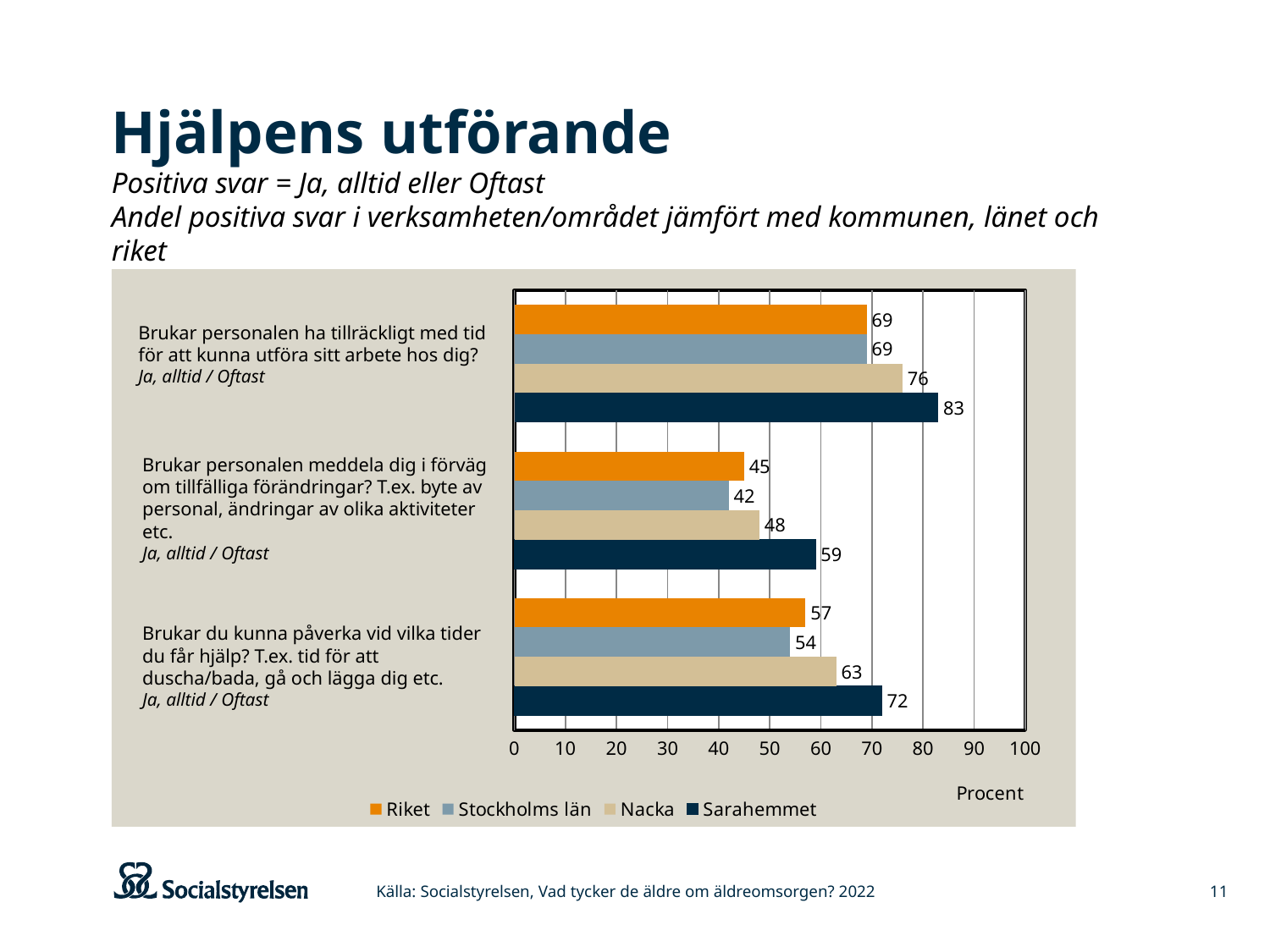
What is the value for Sarahemmet on the question 'Brukar personalen ha tillräckligt med tid för att kunna utföra sitt arbete hos dig?' 83 What is the difference between Sarahemmet and Riket on the question 'Brukar personalen ha tillräckligt med tid för att kunna utföra sitt arbete hos dig?' 14 What is the value for Nacka on the question 'Brukar du kunna påverka vid vilka tider du får hjälp?' 63 Which is larger on the question 'Brukar personalen meddela dig i förväg om tillfälliga förändringar?': Riket or Nacka? Nacka Which series has the highest value on the question 'Brukar du kunna påverka vid vilka tider du får hjälp?' Sarahemmet How many questions (categories) are shown in the chart? 3 What kind of chart is shown on the slide? Bar chart How many series does the legend list? 4 What unit is shown on the horizontal axis of the chart? Procent What is the difference between Nacka and Stockholms län on the question 'Brukar du kunna påverka vid vilka tider du får hjälp?' 9 Which series has the lowest value on the question 'Brukar personalen meddela dig i förväg om tillfälliga förändringar?' Stockholms län What is the value for Stockholms län on the question 'Brukar personalen meddela dig i förväg om tillfälliga förändringar?' 42